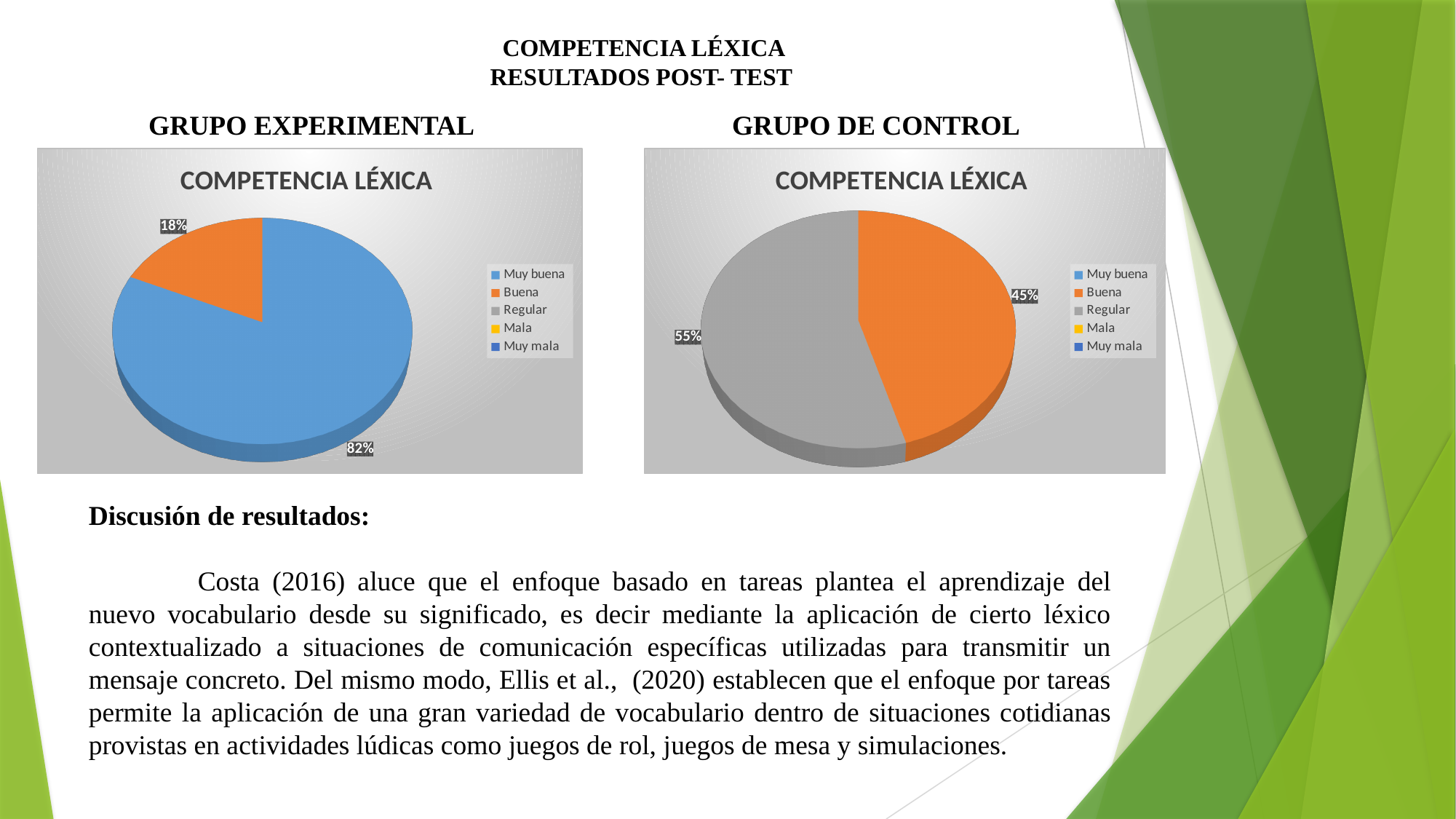
In the GRUPO DE CONTROL chart, what share does Regular have? 55% In the GRUPO EXPERIMENTAL chart, which category has the largest slice? Muy buena In the GRUPO EXPERIMENTAL chart, what share does Buena have? 18% In the GRUPO DE CONTROL chart, what is the difference between the Regular and Buena shares? 10% In the GRUPO DE CONTROL chart, which is larger, Buena or Regular? Regular How many entries does the legend of the GRUPO DE CONTROL chart list? 5 In the GRUPO EXPERIMENTAL chart, what is the difference between the Muy buena and Buena shares? 64% In the GRUPO DE CONTROL chart, what share does Buena have? 45% What is the title shown inside the GRUPO EXPERIMENTAL chart? COMPETENCIA LÉXICA In the GRUPO EXPERIMENTAL chart, what share does Muy buena have? 82% In the GRUPO DE CONTROL chart, which category has the largest slice? Regular What type of chart is used for the GRUPO EXPERIMENTAL results? Pie chart